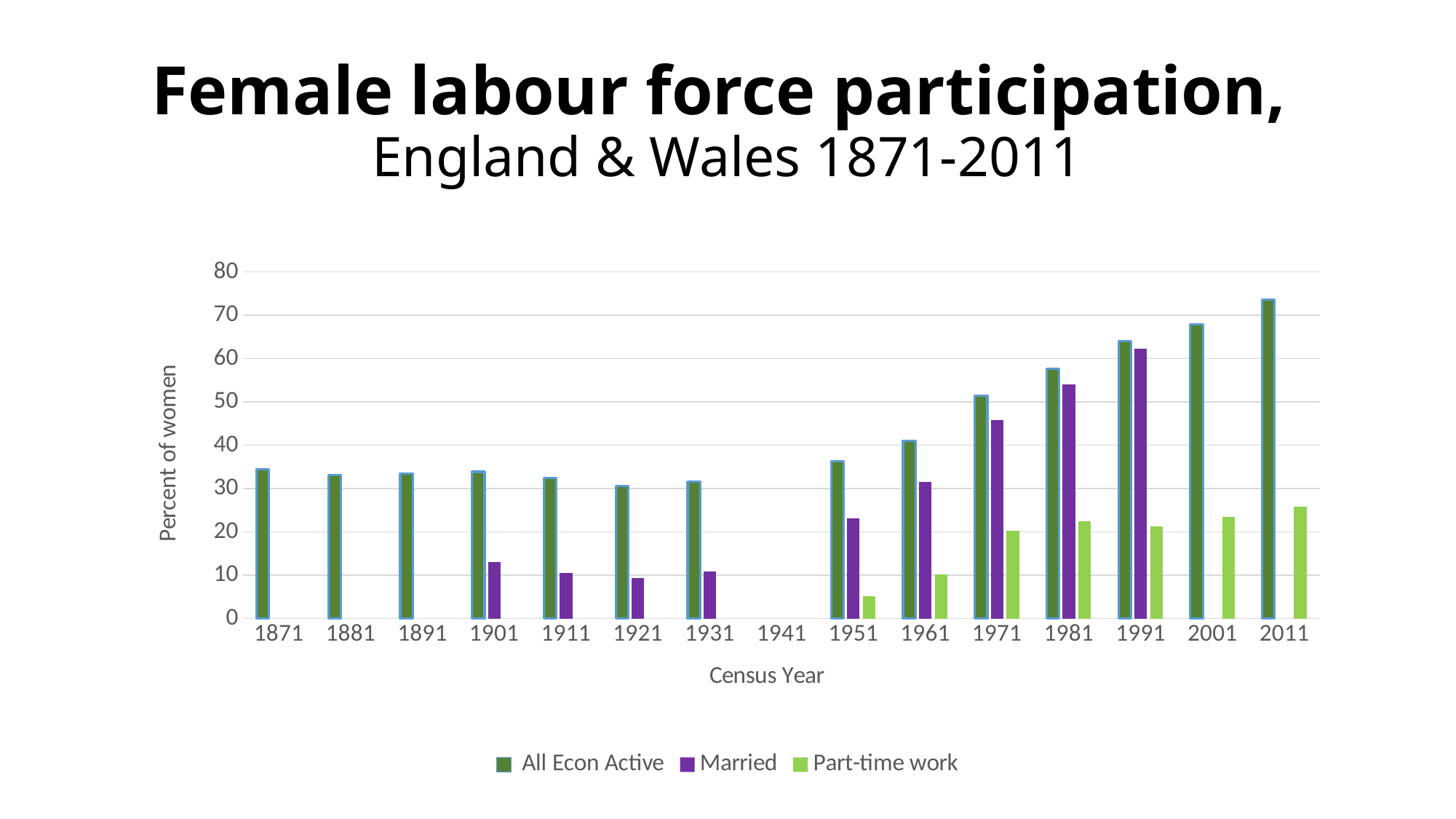
What is the label on the y axis? Percent of women What kind of chart is shown on the slide? Bar chart In which census year is the All Econ Active value highest? 2011 Is the Part-time work value for 1951 greater or less than 10? less Is the All Econ Active value for 2011 greater or less than 70? greater In which census year is the Part-time work value lowest? 1951 Do the All Econ Active values rise or fall from 1951 to 2011? Rise How many series does the legend list? 3 In which census year is the Married value highest? 1991 Which is larger, the Married value for 1901 or the Married value for 1951? 1951 Is the Married value for 1951 greater or less than 20? greater How many census years are shown on the x axis? 15